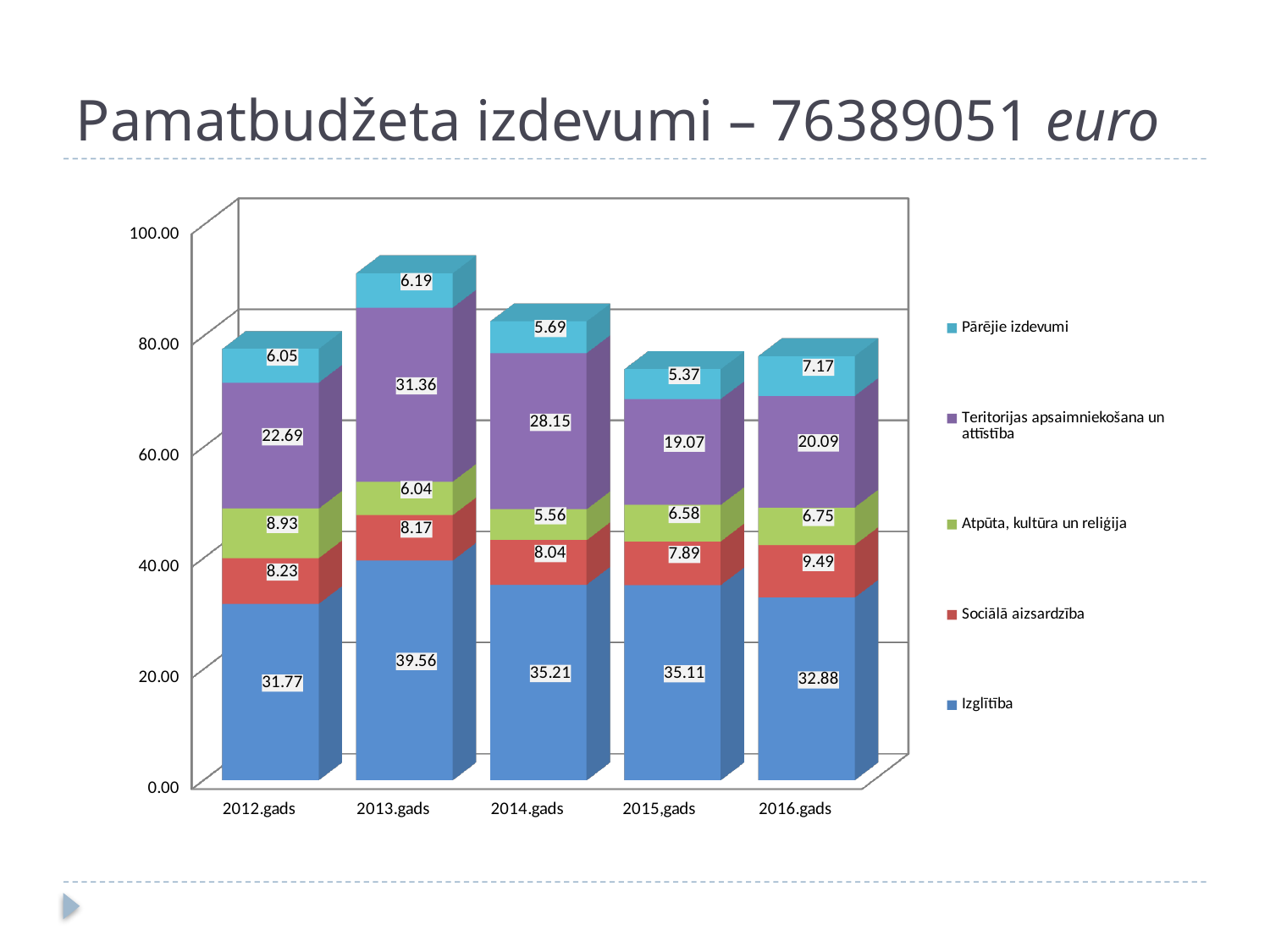
How many years are shown on the x axis? 5 What is the value for Teritorijas apsaimniekošana un attīstība in 2015,gads? 19.07 What is the total of the stacked bar for 2012.gads? 77.67 What is the value for Izglītība in 2013.gads? 39.56 What kind of chart is shown on the slide? Stacked bar chart Which is larger: Sociālā aizsardzība in 2016.gads or in 2015,gads? 2016.gads Which legend entry is shown in purple? Teritorijas apsaimniekošana un attīstība How many series does the legend list? 5 What is the difference between the Teritorijas apsaimniekošana un attīstība values for 2013.gads and 2012.gads? 8.67 In which year is the Atpūta, kultūra un reliģija value lowest? 2014.gads What is the value for Pārējie izdevumi in 2016.gads? 7.17 In which year is the Izglītība value highest? 2013.gads